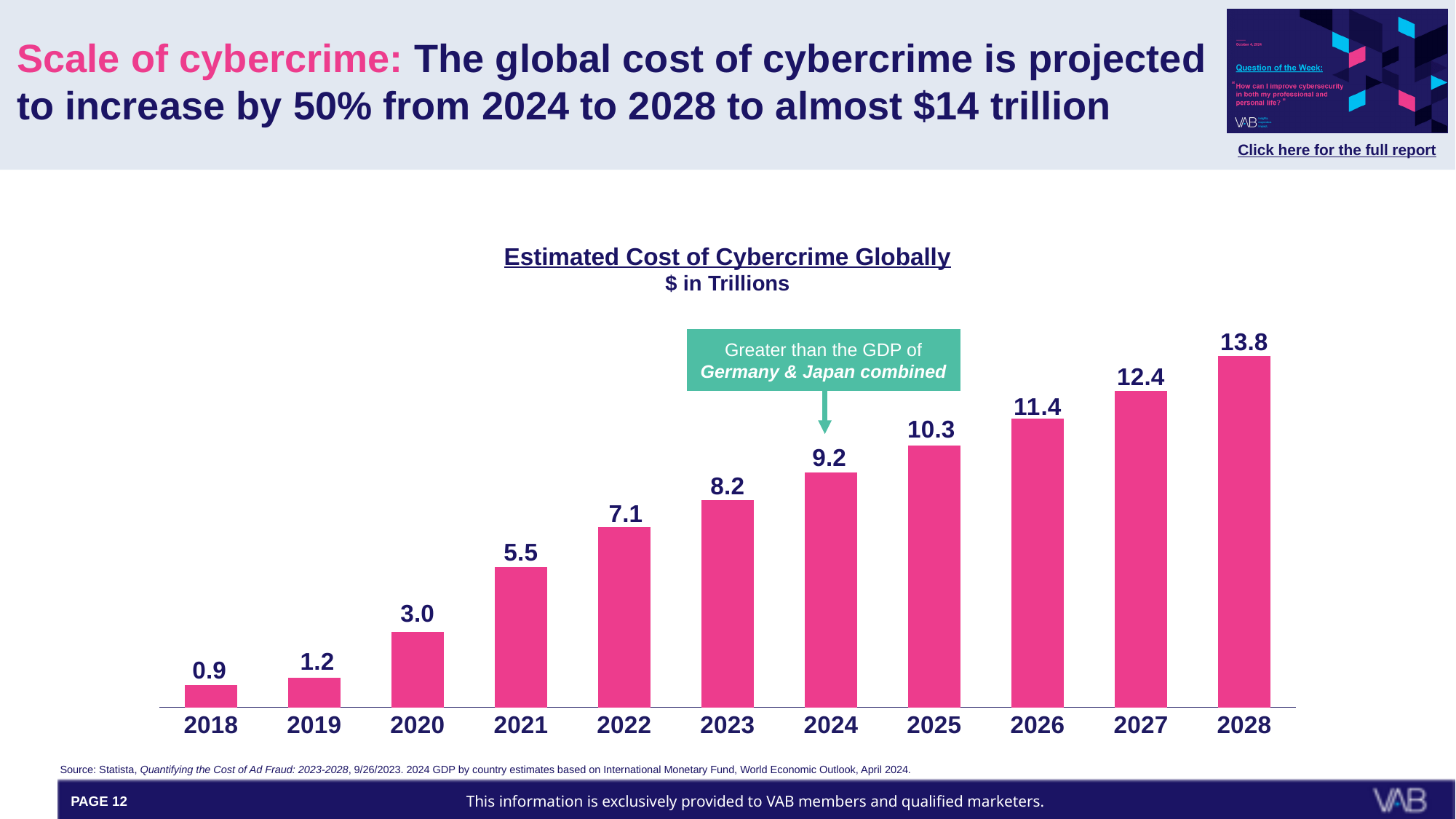
What is the difference between the estimated cost of cybercrime in 2020 and in 2019? 1.8 Do the estimated costs of cybercrime rise or fall from 2018 to 2028? Rise Which year has the lowest estimated cost of cybercrime? 2018 What unit is the estimated cost of cybercrime expressed in, according to the chart subtitle? $ in Trillions What is the difference between the estimated cost of cybercrime in 2028 and in 2024? 4.6 How many years are shown on the chart? 11 Which year has the highest estimated cost of cybercrime? 2028 What is the estimated cost of cybercrime globally for 2018? 0.9 What is the estimated cost of cybercrime globally for 2021? 5.5 What kind of chart is used to show the estimated cost of cybercrime globally? Bar chart What is the estimated cost of cybercrime globally for 2024? 9.2 Which year has a higher estimated cost of cybercrime, 2022 or 2025? 2025